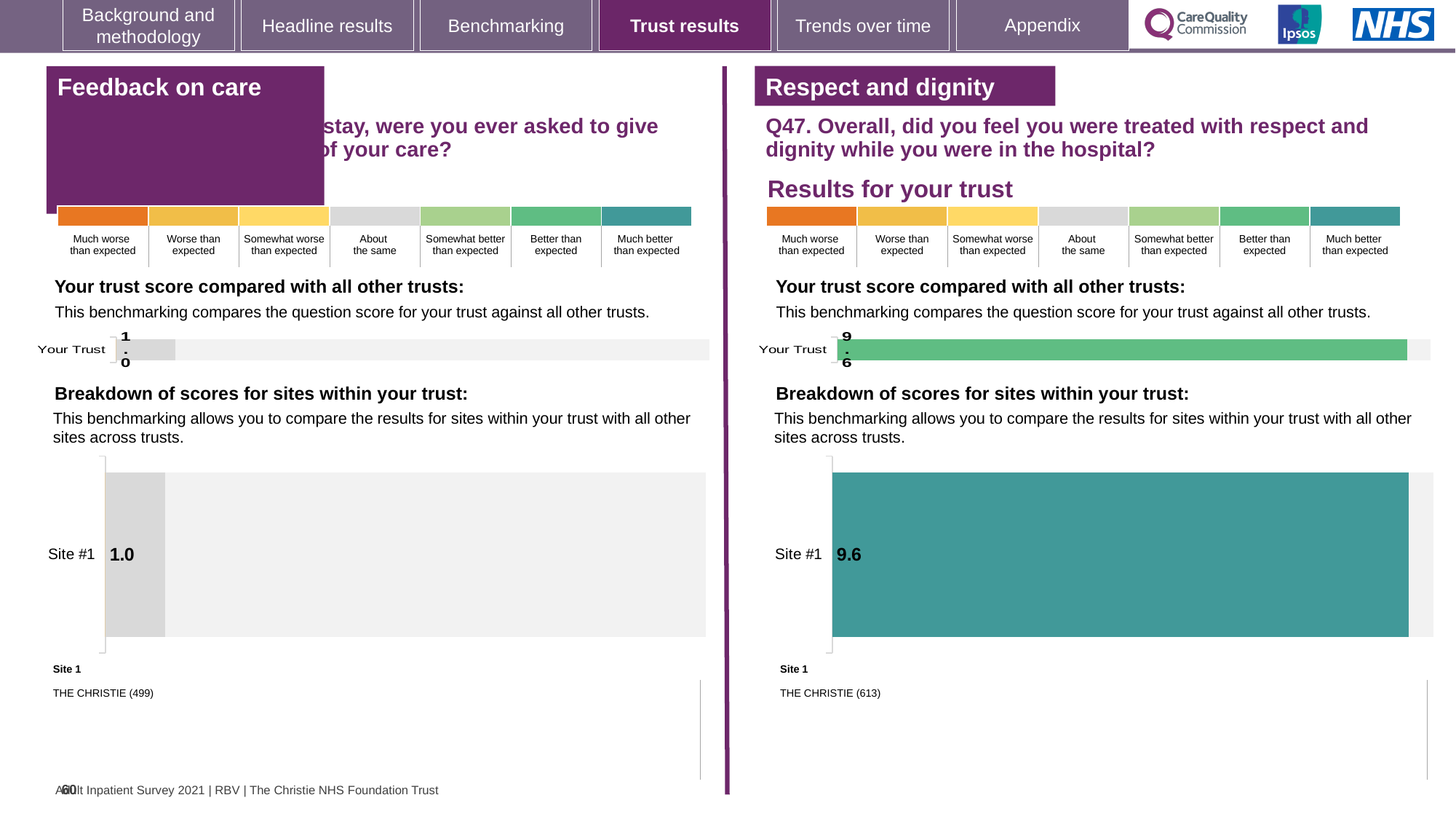
What kind of chart is used to show the Site #1 score in the 'Respect and dignity' section? Bar chart On the right-hand 'Respect and dignity' section, what is the score shown for Site #1 in the breakdown of scores for sites within your trust? 9.6 How many sites are shown in the breakdown of scores chart in the 'Feedback on care' section? 1 On the left-hand 'Feedback on care' section, what is the 'Your Trust' score in the trust score comparison chart? 1.0 On the left-hand 'Feedback on care' section, what is the score shown for Site #1 in the breakdown of scores for sites within your trust? 1.0 In the 'Respect and dignity' section, which site name is listed as Site 1 below the chart? THE CHRISTIE (613) On the right-hand 'Respect and dignity' section, what is the 'Your Trust' score in the trust score comparison chart? 9.6 What is the difference between the Site #1 score in the 'Respect and dignity' section and the Site #1 score in the 'Feedback on care' section? 8.6 How many sites are shown in the breakdown of scores chart in the 'Respect and dignity' section? 1 In the 'Feedback on care' section, which site name is listed as Site 1 below the chart? THE CHRISTIE (499) Which question number is shown for the 'Respect and dignity' section? Q47 Which section's Site #1 bar shows the larger score: 'Feedback on care' on the left or 'Respect and dignity' on the right? Respect and dignity